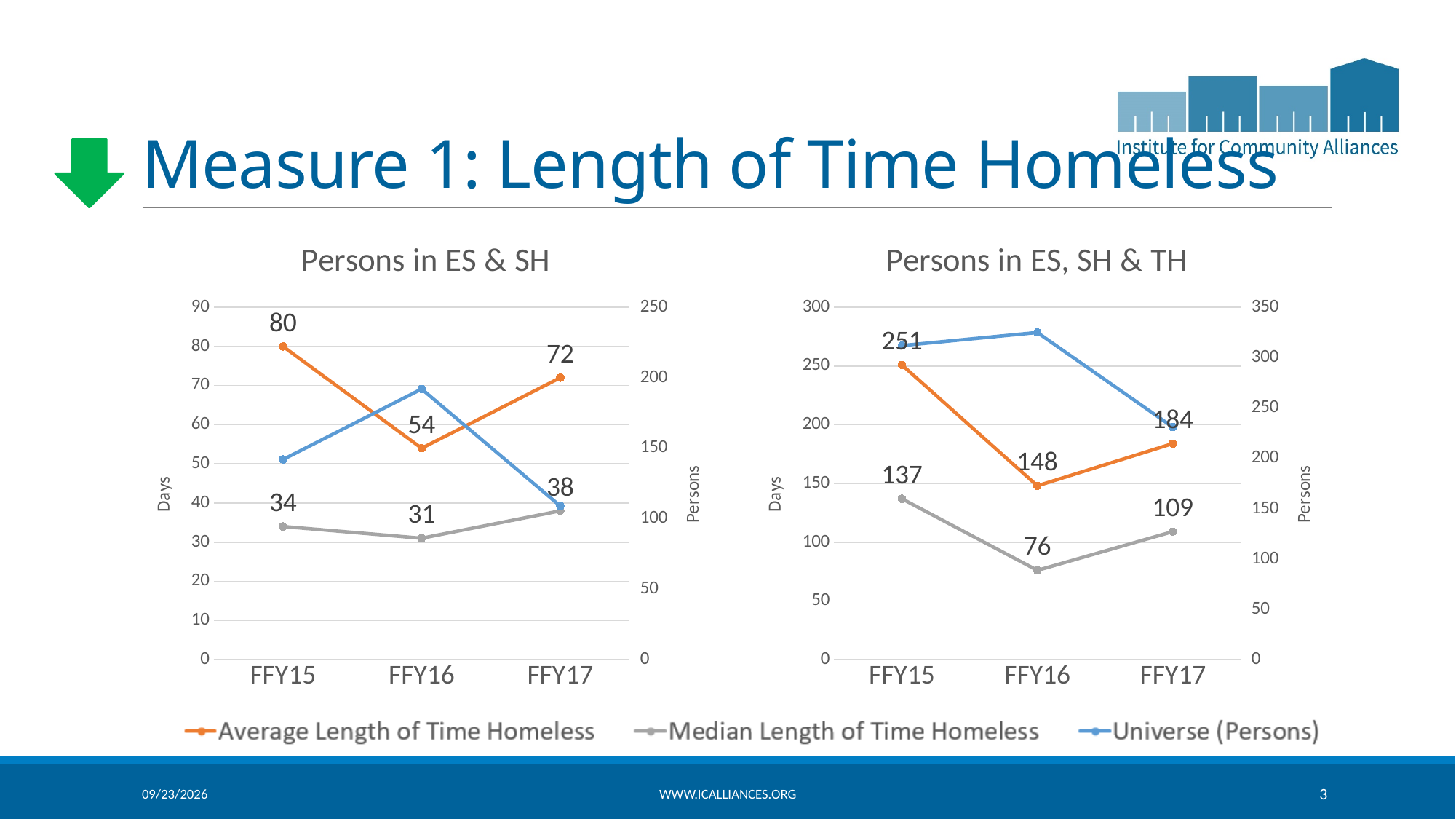
What type of chart is the 'Persons in ES & SH' chart? Line chart In the 'Persons in ES & SH' chart, which year has the lowest Average Length of Time Homeless? FFY16 In the 'Persons in ES, SH & TH' chart, what is the difference between the Average and Median Length of Time Homeless in FFY15? 114 In the 'Persons in ES & SH' chart, is the Median Length of Time Homeless higher in FFY17 or FFY16? FFY17 In the 'Persons in ES, SH & TH' chart, is the Universe (Persons) value for FFY17 greater or less than 250? less How many series does the legend list for the charts on this slide? 3 In the 'Persons in ES, SH & TH' chart, what is the Average Length of Time Homeless for FFY17? 184 In the 'Persons in ES, SH & TH' chart, which year has the highest Average Length of Time Homeless? FFY15 In the 'Persons in ES & SH' chart, what is the difference between the Average Length of Time Homeless in FFY15 and FFY16? 26 In the 'Persons in ES & SH' chart, is the Universe (Persons) value for FFY16 greater or less than 150? greater In the 'Persons in ES, SH & TH' chart, what is the Median Length of Time Homeless for FFY16? 76 In the 'Persons in ES & SH' chart, what is the Average Length of Time Homeless for FFY15? 80